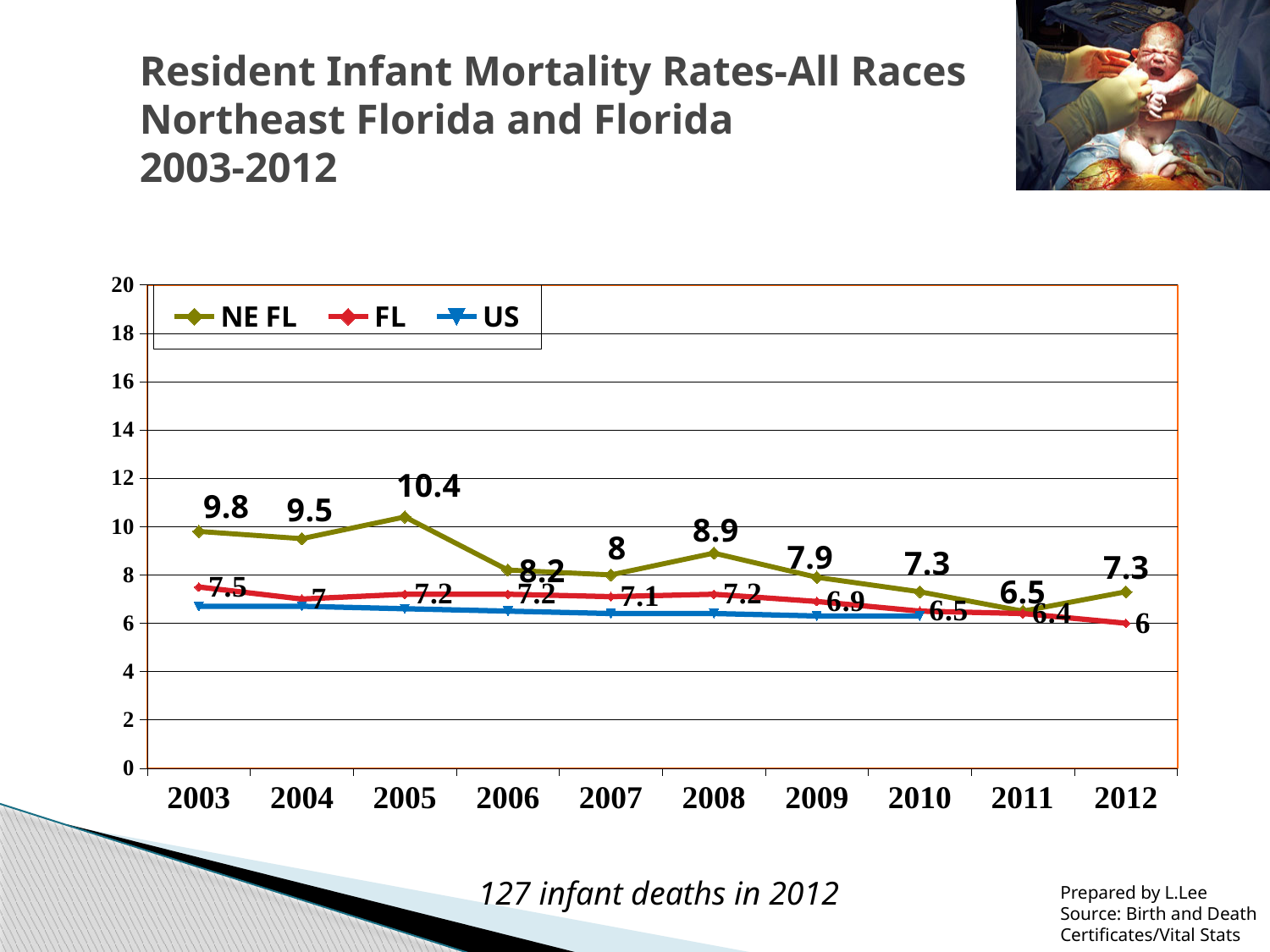
Does the NE FL rate generally rise or fall from 2003 to 2012? Fall Is the US rate in 2003 greater or less than 8? less In which year is the NE FL rate highest? 2005 In which year is the FL rate lowest? 2012 What is the NE FL infant mortality rate in 2005? 10.4 What is the difference between the NE FL rate in 2003 and in 2012? 2.5 In 2008, which is larger, the NE FL rate or the FL rate? NE FL What is the FL infant mortality rate in 2012? 6 How many years are plotted along the x axis? 10 In which year is the NE FL rate lowest? 2011 How many series does the legend list? 3 What kind of chart is shown on the slide? Line chart